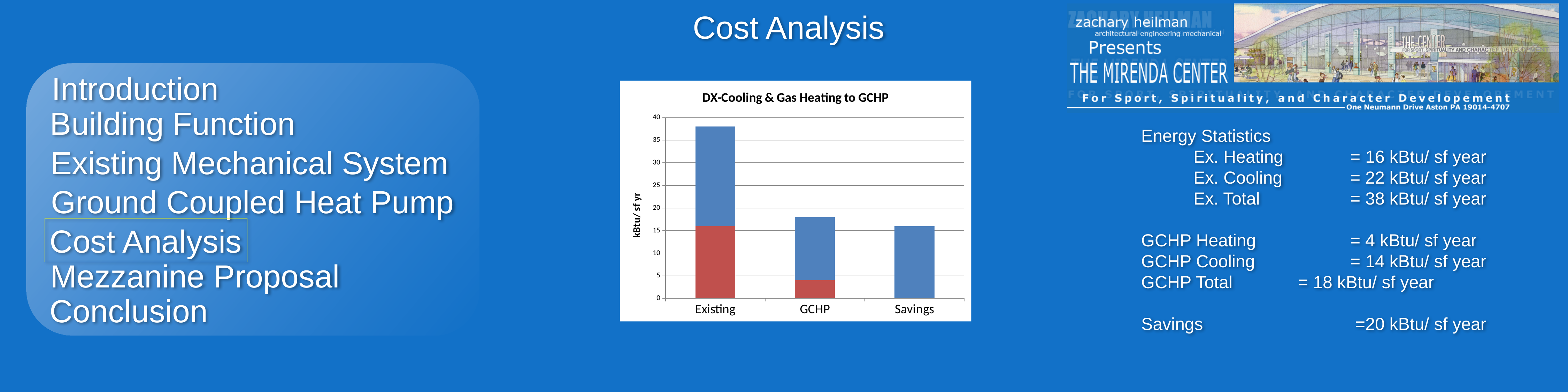
Is the total value for Existing greater or less than 35? greater What kind of chart is shown on the slide? bar chart Which category has the tallest bar in the chart? Existing How many categories are shown on the x axis of the chart? 3 Which bar is taller, Existing or GCHP? Existing What is the title of the chart? DX-Cooling & Gas Heating to GCHP What is the label on the y axis of the chart? kBtu/ sf yr What is the difference between the Existing total and the GCHP total, in kBtu/ sf year? 20 kBtu/ sf year What is the total of the stacked Existing bar, in kBtu/ sf year? 38 kBtu/ sf year Is the value for Savings greater or less than 10? greater Which category has the shortest bar in the chart? Savings Is the total value for GCHP greater or less than 20? less